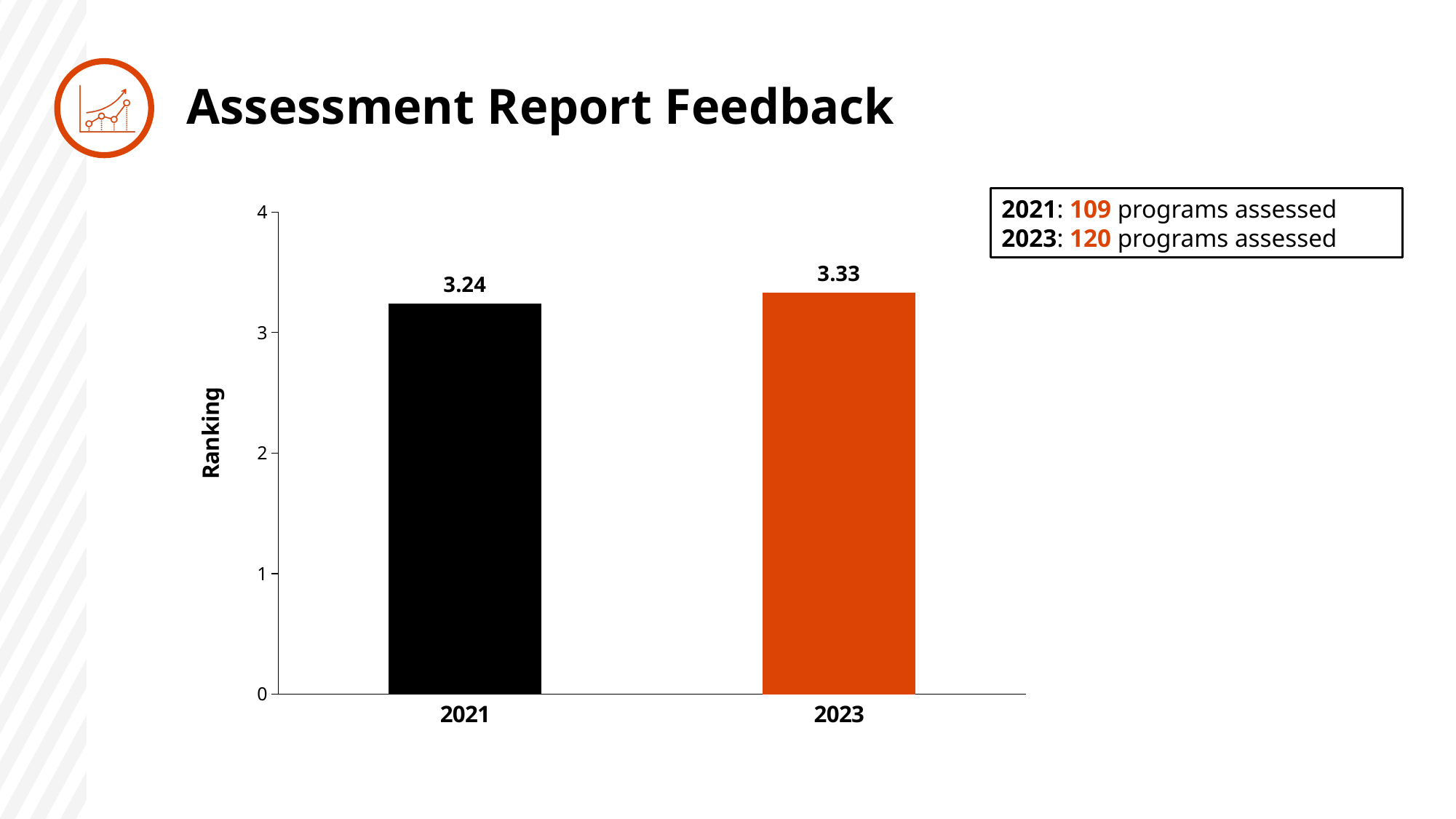
What is the label on the y axis? Ranking What colour is the bar for 2023? orange Is the ranking for 2023 greater or less than 4? less What is the ranking value for 2023? 3.33 How many years are shown on the x axis? 2 Is the ranking for 2021 greater or less than 3? greater What kind of chart is shown on the slide? bar chart Which year has the higher ranking? 2023 What is the difference between the 2023 and 2021 ranking values? 0.09 Does the ranking rise or fall from 2021 to 2023? rise What is the ranking value for 2021? 3.24 Which year has the lower ranking? 2021